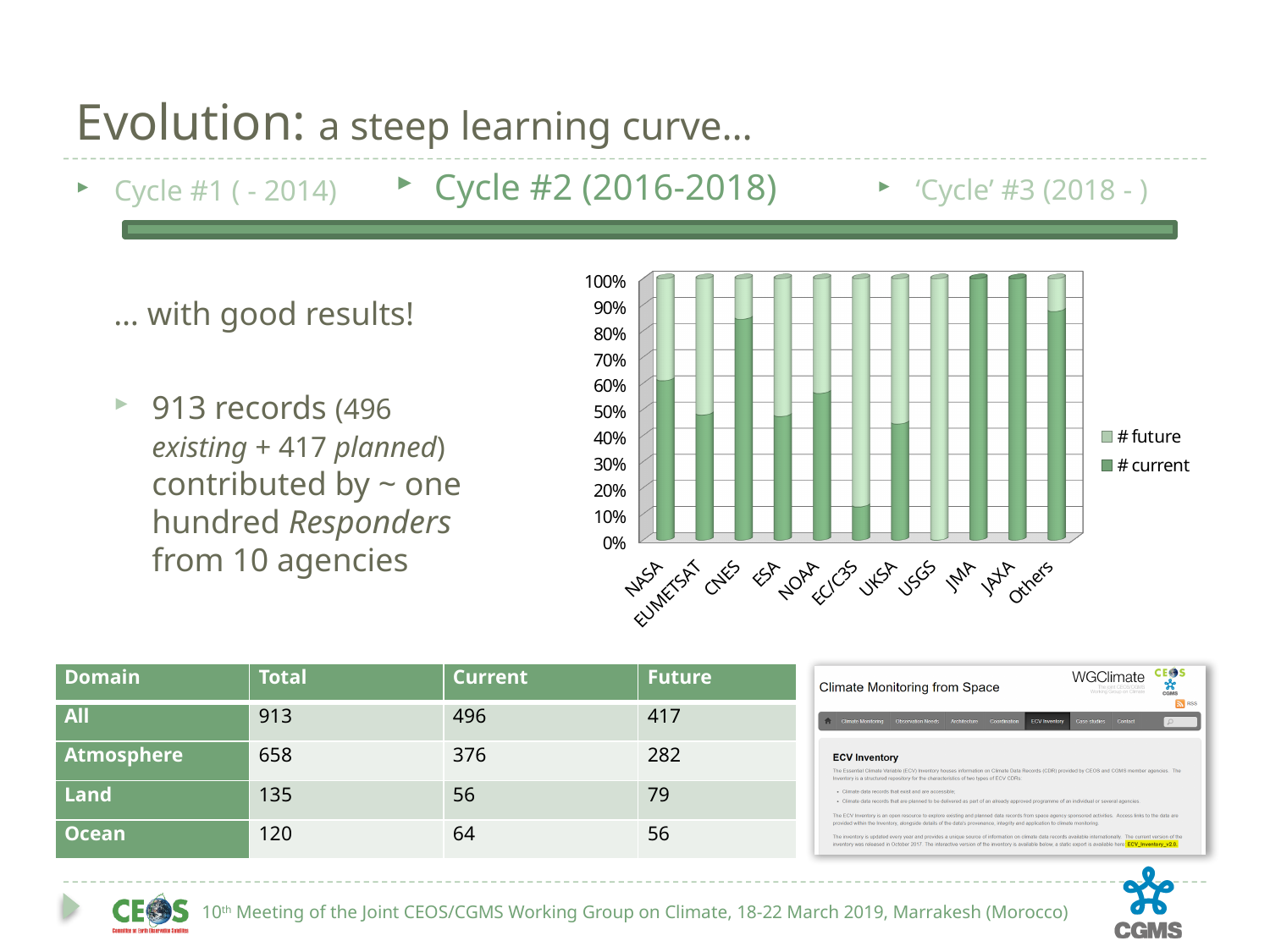
What are the two series named in the chart legend? # future and # current Which category has the lowest share of # current records in the chart? USGS What kind of chart is shown on the slide? Stacked bar chart Which category has the highest share of # future records in the chart? USGS How many series does the chart legend list? 2 How many agencies/categories are shown along the x axis of the chart? 11 Which has a larger # current share, NASA or EC/C3S? NASA Is the # current share for UKSA greater or less than 50%? less Is the # current share for EC/C3S greater or less than 20%? less Is the # current share for CNES greater or less than 80%? greater Which has a larger # current share, CNES or EUMETSAT? CNES